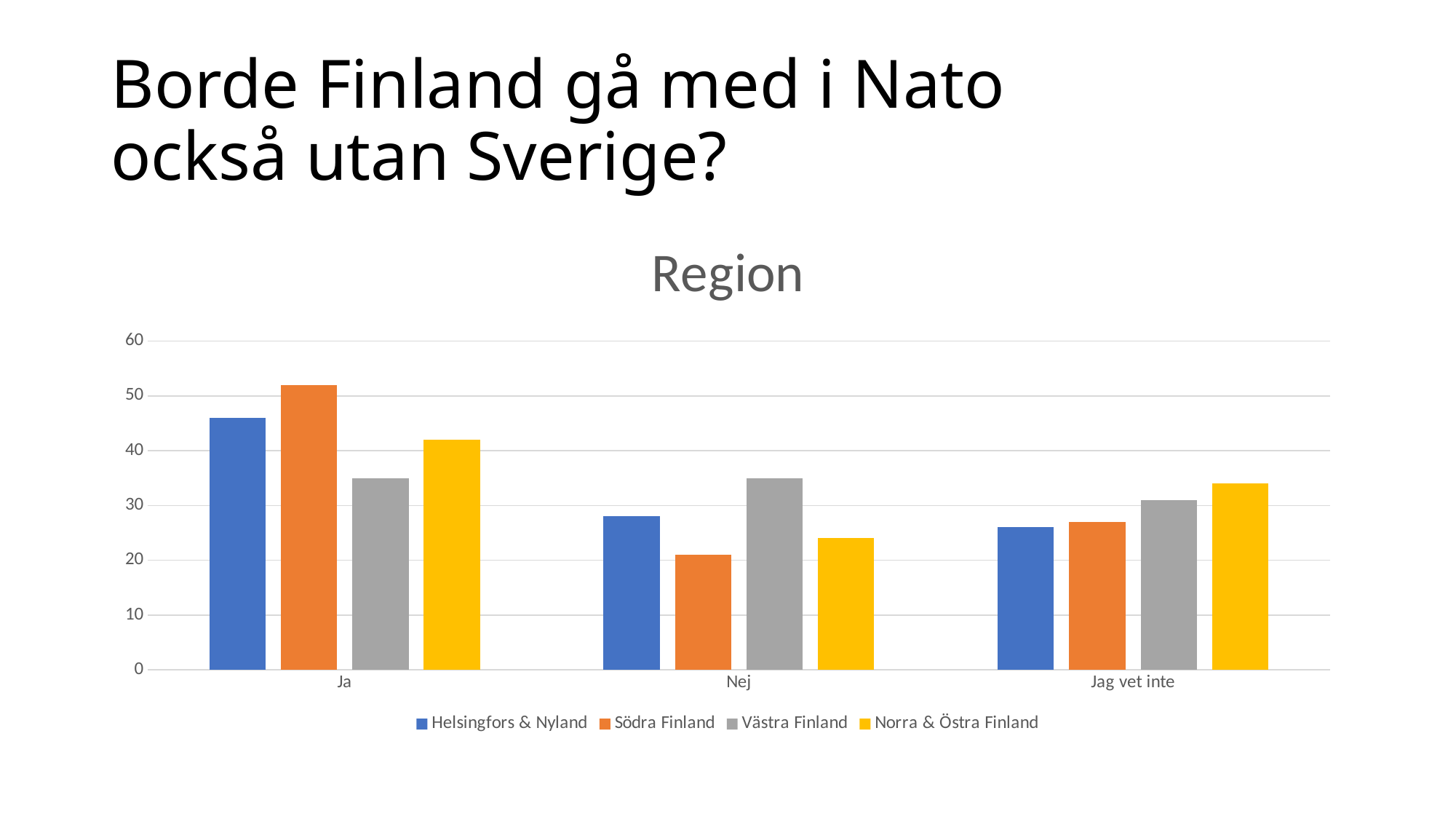
How many series does the chart's legend list? 4 Is the value for Helsingfors & Nyland in the Ja category greater or less than 40? greater In the Jag vet inte category, which region has the highest value? Norra & Östra Finland In the Ja category, which is larger: Södra Finland or Västra Finland? Södra Finland Is the value for Norra & Östra Finland in the Nej category greater or less than 30? less In the Nej category, which region has the lowest value? Södra Finland How many answer categories are shown on the x axis of the chart? 3 What is the title of the chart? Region What kind of chart is shown on the slide? bar chart Is the value for Södra Finland in the Ja category greater or less than 50? greater In the Ja category, which region has the highest value? Södra Finland